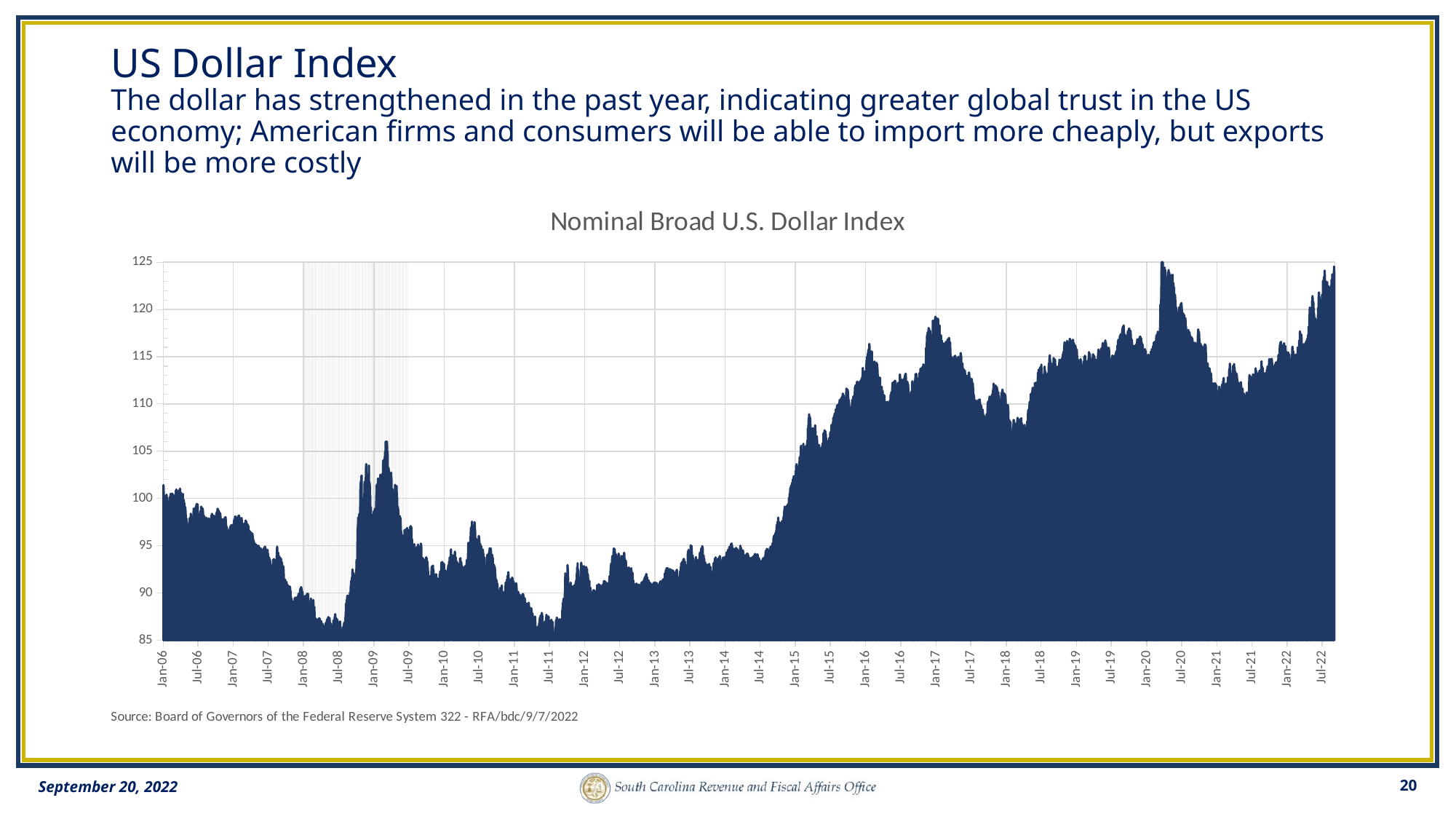
Is the value of the index at Jul-22 greater or less than 120? greater What is the source cited below the chart? Board of Governors of the Federal Reserve System Is the value of the index at Jul-11 greater or less than 90? less Is the value of the index at Jan-17 greater or less than 115? greater What kind of chart is shown on the slide? Area chart What is the title of the chart? Nominal Broad U.S. Dollar Index Does the index rise or fall between Jan-06 and Jul-08? fall Does the index rise or fall between Jan-21 and Jul-22? rise